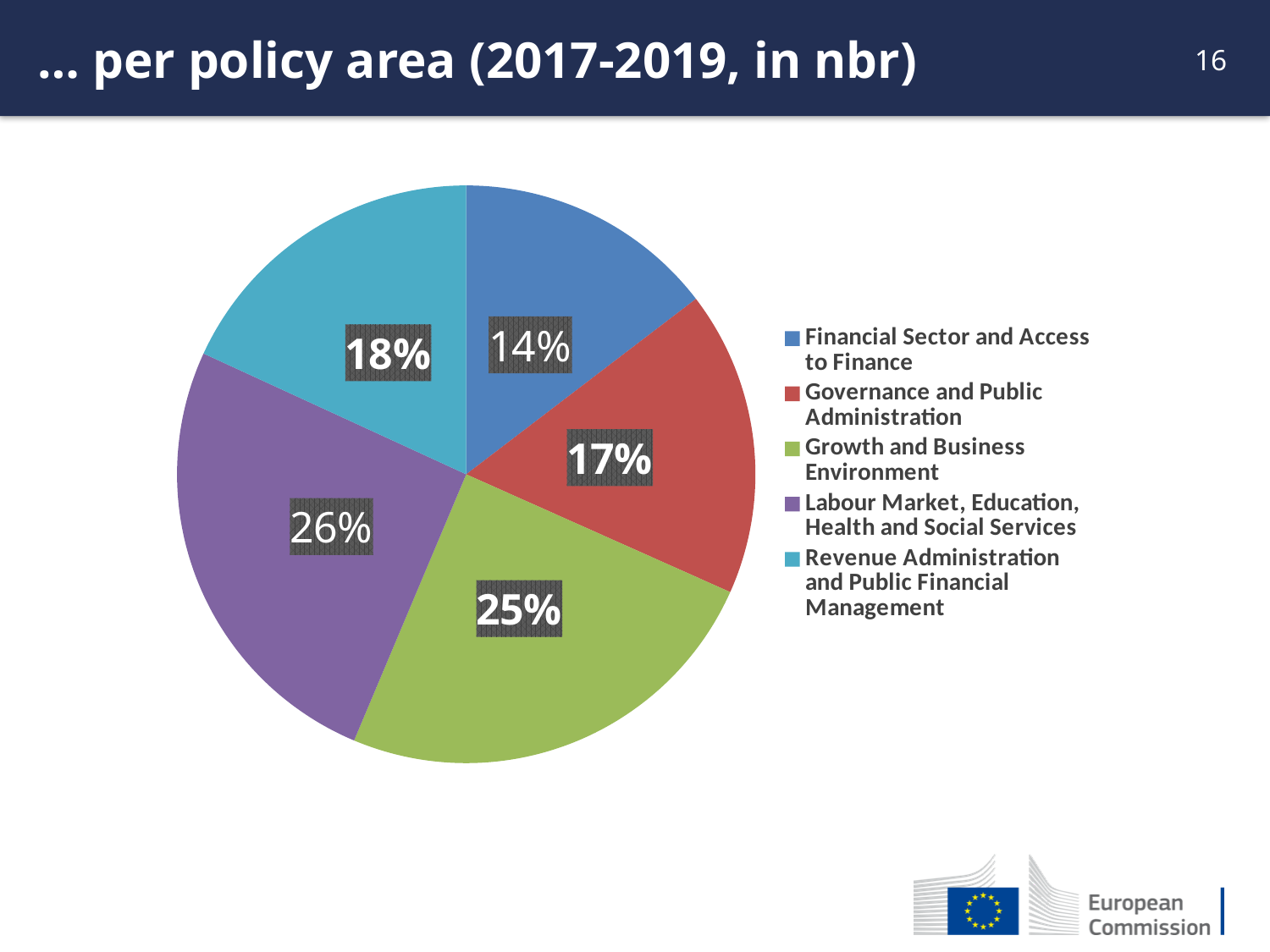
Which is larger: the share for Revenue Administration and Public Financial Management or the share for Governance and Public Administration? Revenue Administration and Public Financial Management Which policy area has the smallest share of the pie? Financial Sector and Access to Finance What share of the pie is Growth and Business Environment? 25% What share of the pie is Labour Market, Education, Health and Social Services? 26% What share of the pie is Financial Sector and Access to Finance? 14% What kind of chart is shown on the slide? pie chart What share of the pie is Governance and Public Administration? 17% What share of the pie is Revenue Administration and Public Financial Management? 18% What colour is the slice for Growth and Business Environment? green What is the difference in percentage points between Growth and Business Environment and Financial Sector and Access to Finance? 11 How many policy areas (slices) does the pie chart show? 5 Which policy area has the largest share of the pie? Labour Market, Education, Health and Social Services